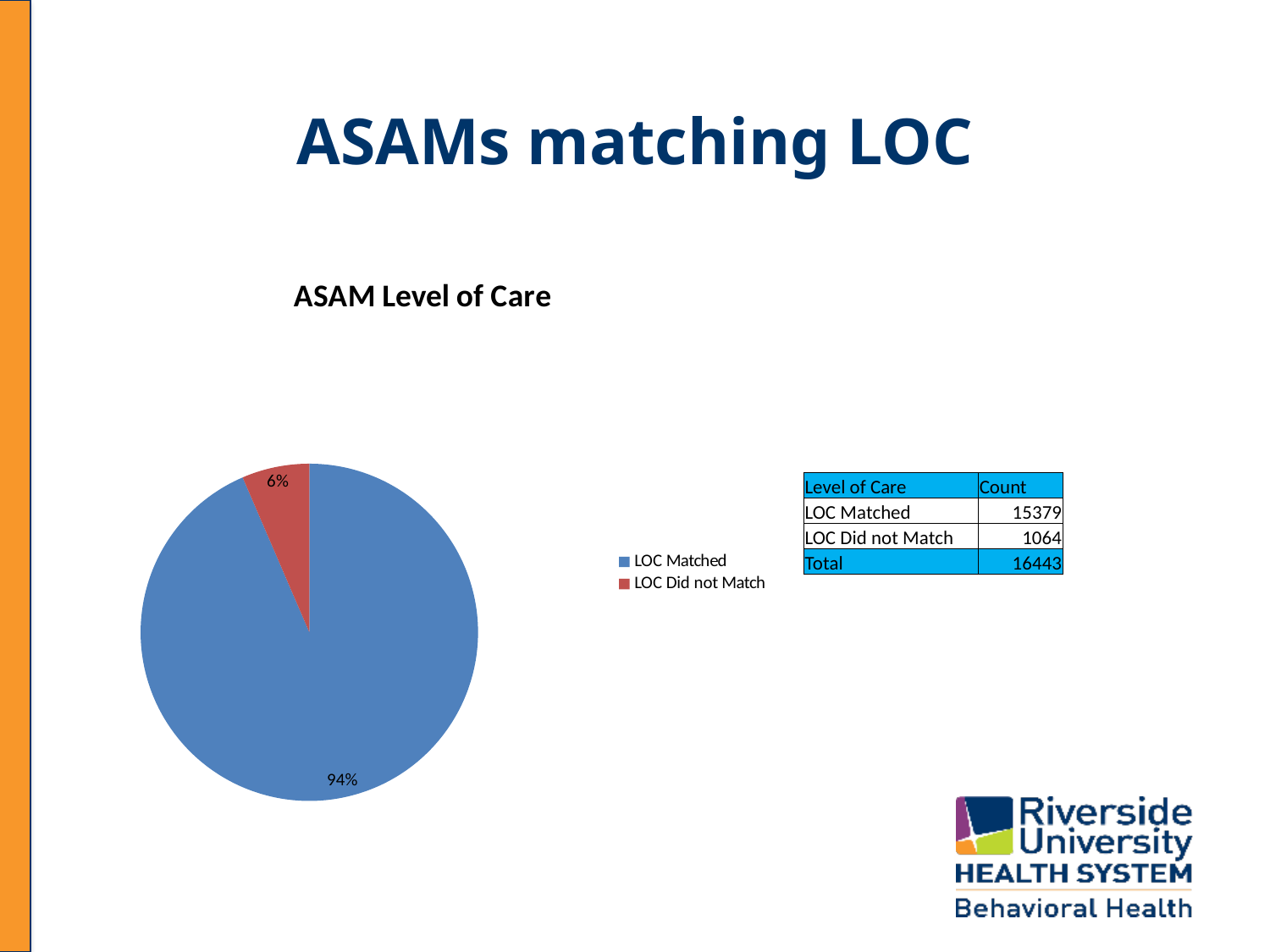
What is the title of the chart? ASAM Level of Care How many slices does the pie chart have? 2 What is the difference in percentage points between the LOC Matched and LOC Did not Match slices? 88 What percentage of the pie does LOC Did not Match represent? 6% What kind of chart is shown on the slide? pie chart What colour is the LOC Did not Match slice? red How many entries does the legend list? 2 Which is larger, the LOC Matched slice or the LOC Did not Match slice? LOC Matched Which slice of the pie is the smallest? LOC Did not Match What percentage of the pie does LOC Matched represent? 94% Which slice of the pie is the largest? LOC Matched